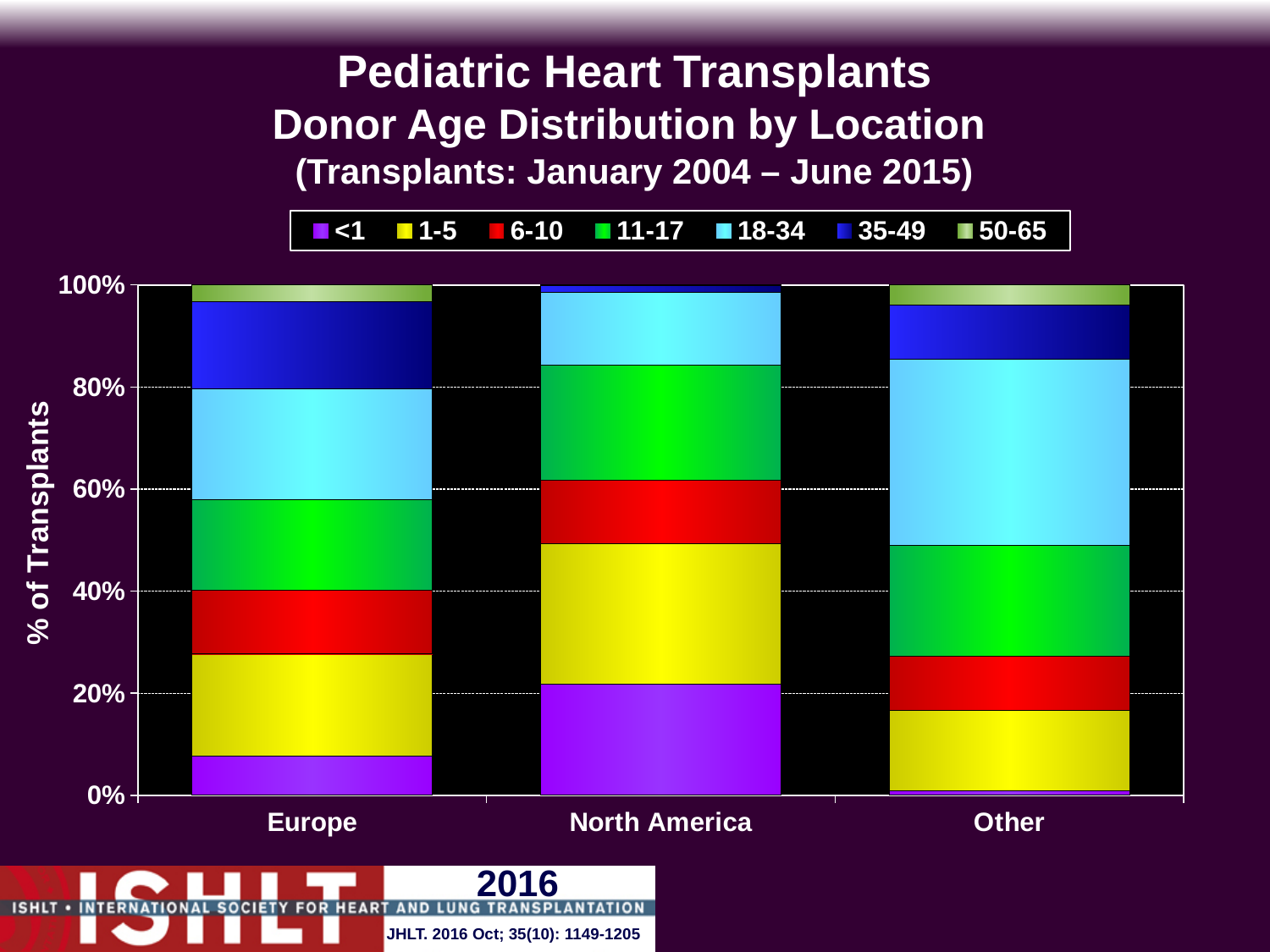
Which location has the larger share of donors aged <1, Europe or North America? North America Which location has the largest share of donors aged 18-34? Other What transplant period does the chart title cover? January 2004 – June 2015 Which location has the largest share of donors aged 35-49? Europe How many donor age groups does the legend list? 7 Is the share of donors aged <1 for Europe greater or less than 20%? less Is the share of donors aged 18-34 for Other greater or less than 20%? greater Is the share of donors aged <1 for North America greater or less than 20%? greater How many locations are shown on the x axis? 3 What kind of chart is shown on the slide? Stacked bar chart What is the label of the y axis? % of Transplants